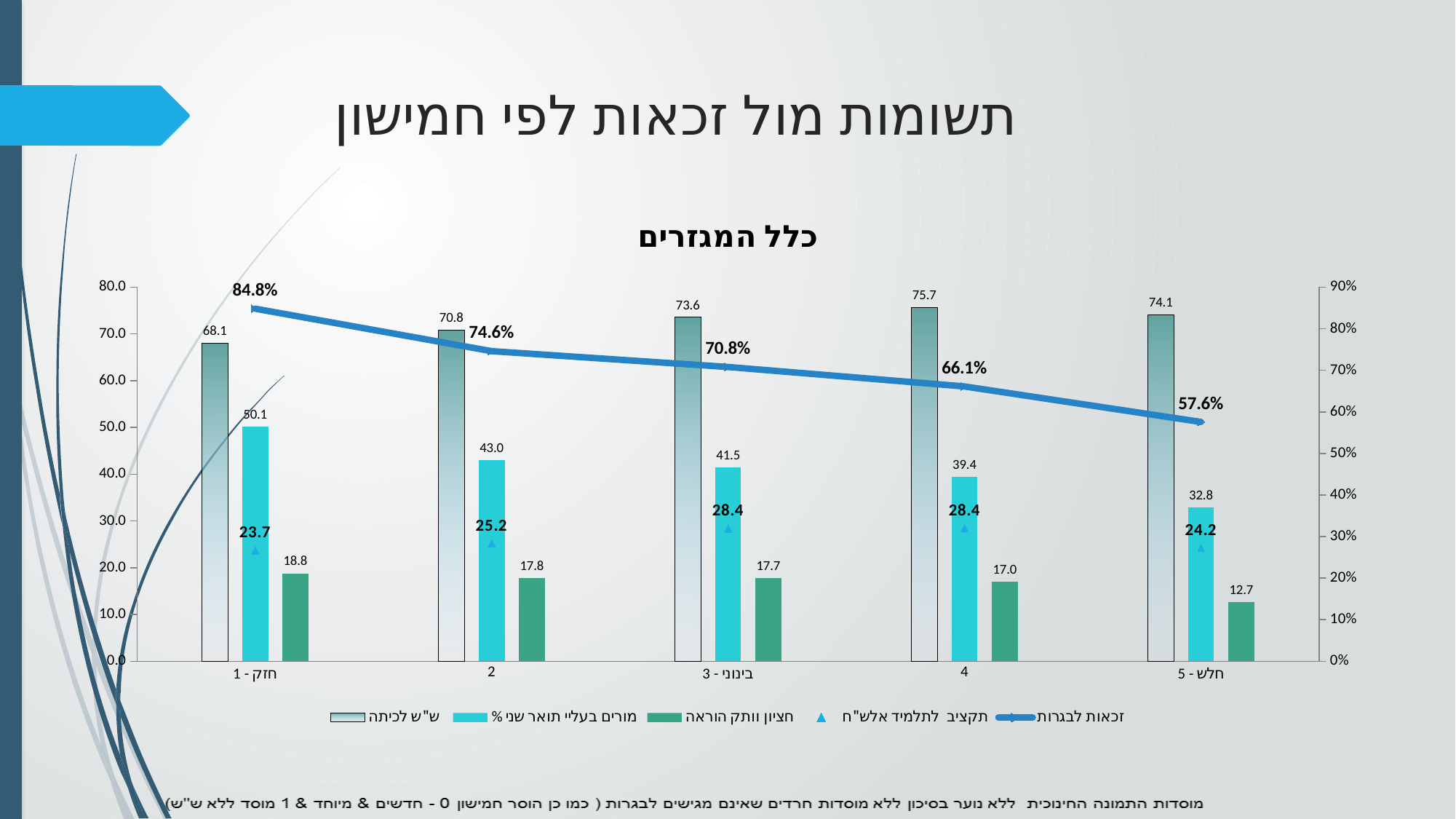
What is the תקציב לתלמיד אלש"ח value for category 2? 25.2 What is the difference between the זכאות לבגרות values for category 1 - חזק and category 5 - חלש? 27.2% Does the זכאות לבגרות line rise or fall from category 1 - חזק to category 5 - חלש? fall How many categories are shown on the x axis? 5 What is the value of מורים בעלי תואר שני % for category 3 - בינוני? 41.5 Which category has the highest value for ש"ש לכיתה? 4 Which is larger: מורים בעלי תואר שני % for category 1 - חזק or for category 4? 1 - חזק What is the value of ש"ש לכיתה for category 1 - חזק? 68.1 What is the זכאות לבגרות percentage for category 5 - חלש? 57.6% Which category has the lowest value for חציון וותק הוראה? 5 - חלש What is the title of the chart? כלל המגזרים How many series does the legend list? 5